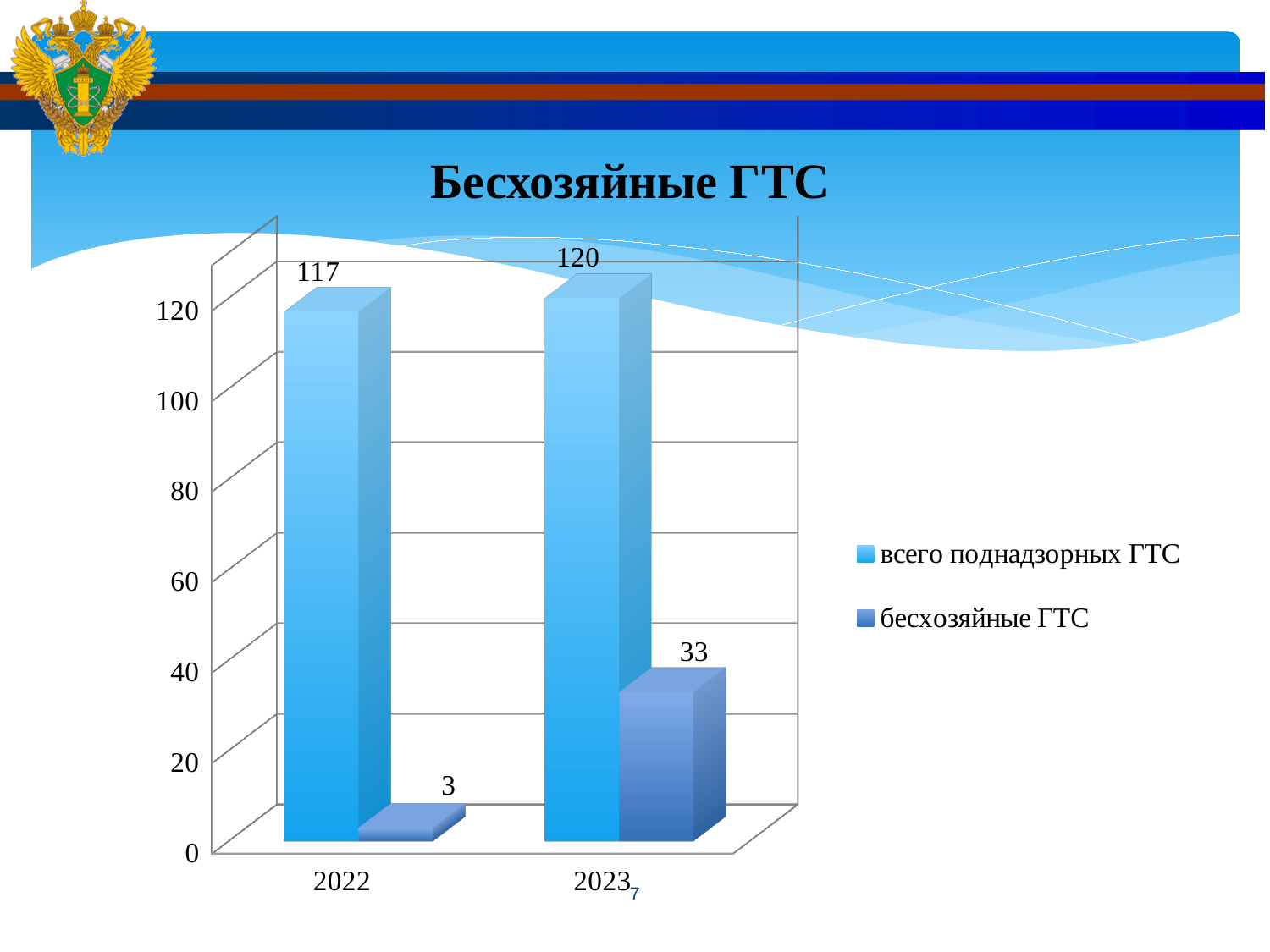
What is the value for "бесхозяйные ГТС" in 2023? 33 What is the value for "бесхозяйные ГТС" in 2022? 3 How many years are shown on the x axis? 2 In which year is the value for "бесхозяйные ГТС" highest? 2023 What is the value for "всего поднадзорных ГТС" in 2022? 117 Which is larger: "бесхозяйные ГТС" in 2023 or "бесхозяйные ГТС" in 2022? 2023 In which year is the value for "всего поднадзорных ГТС" lowest? 2022 What is the difference between the "бесхозяйные ГТС" values for 2023 and 2022? 30 What is the title of the chart? Бесхозяйные ГТС How many series does the legend list? 2 What is the value for "всего поднадзорных ГТС" in 2023? 120 What is the difference between the "всего поднадзорных ГТС" values for 2023 and 2022? 3